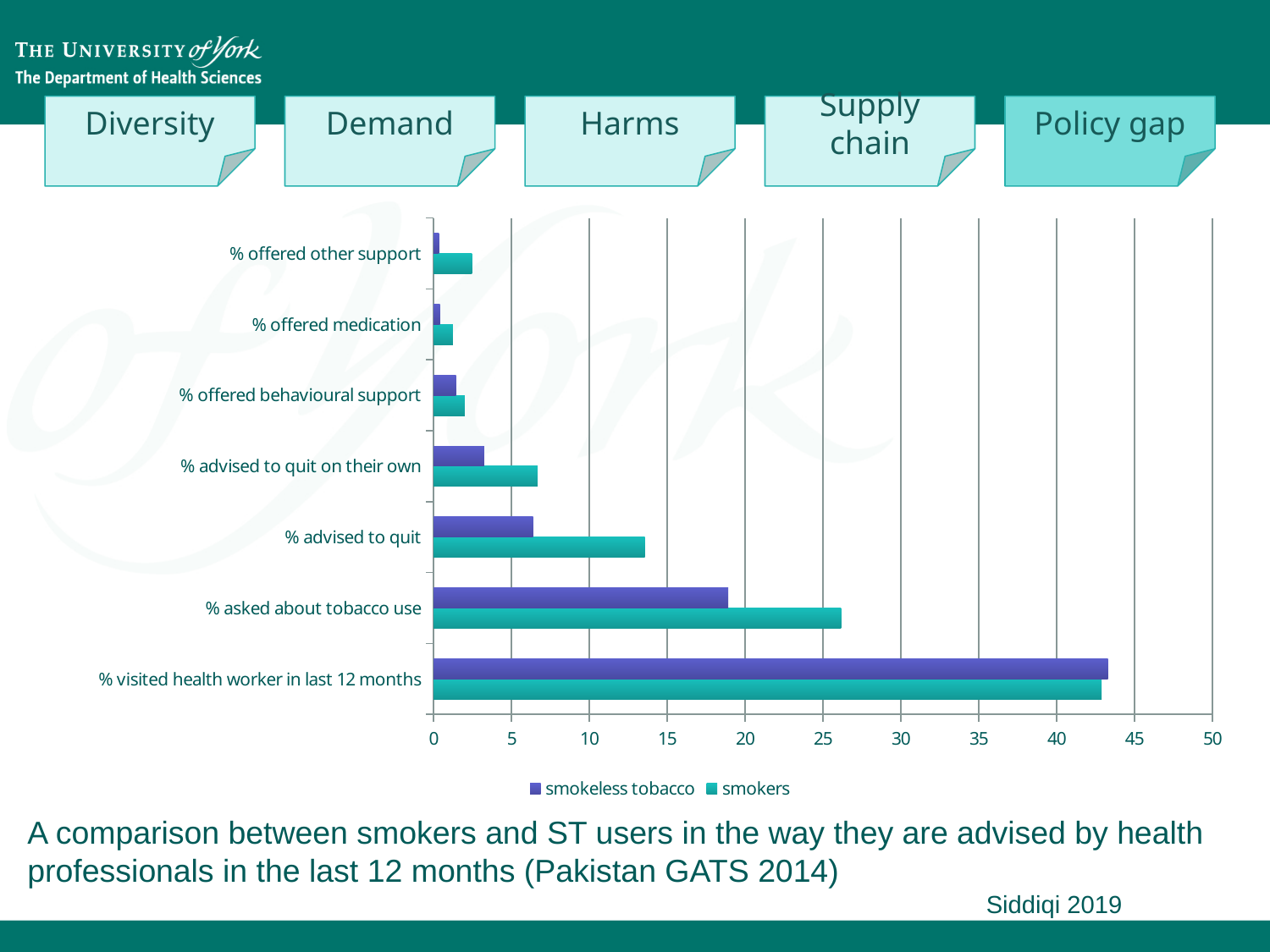
Is the smokeless tobacco value for '% visited health worker in last 12 months' greater or less than 40? greater Which category has the lowest value for the smokers series? % offered medication Is the smokeless tobacco value for '% asked about tobacco use' greater or less than 25? less Is the smokers value for '% asked about tobacco use' greater or less than 20? greater For '% advised to quit', which series has the larger value, smokeless tobacco or smokers? smokers How many categories are plotted on the chart? 7 Which colour represents the smokers series in the chart? teal Which category has the highest value for the smokers series? % visited health worker in last 12 months How many series does the chart legend list? 2 What kind of chart is shown on the slide? bar chart For '% asked about tobacco use', which series has the larger value, smokeless tobacco or smokers? smokers